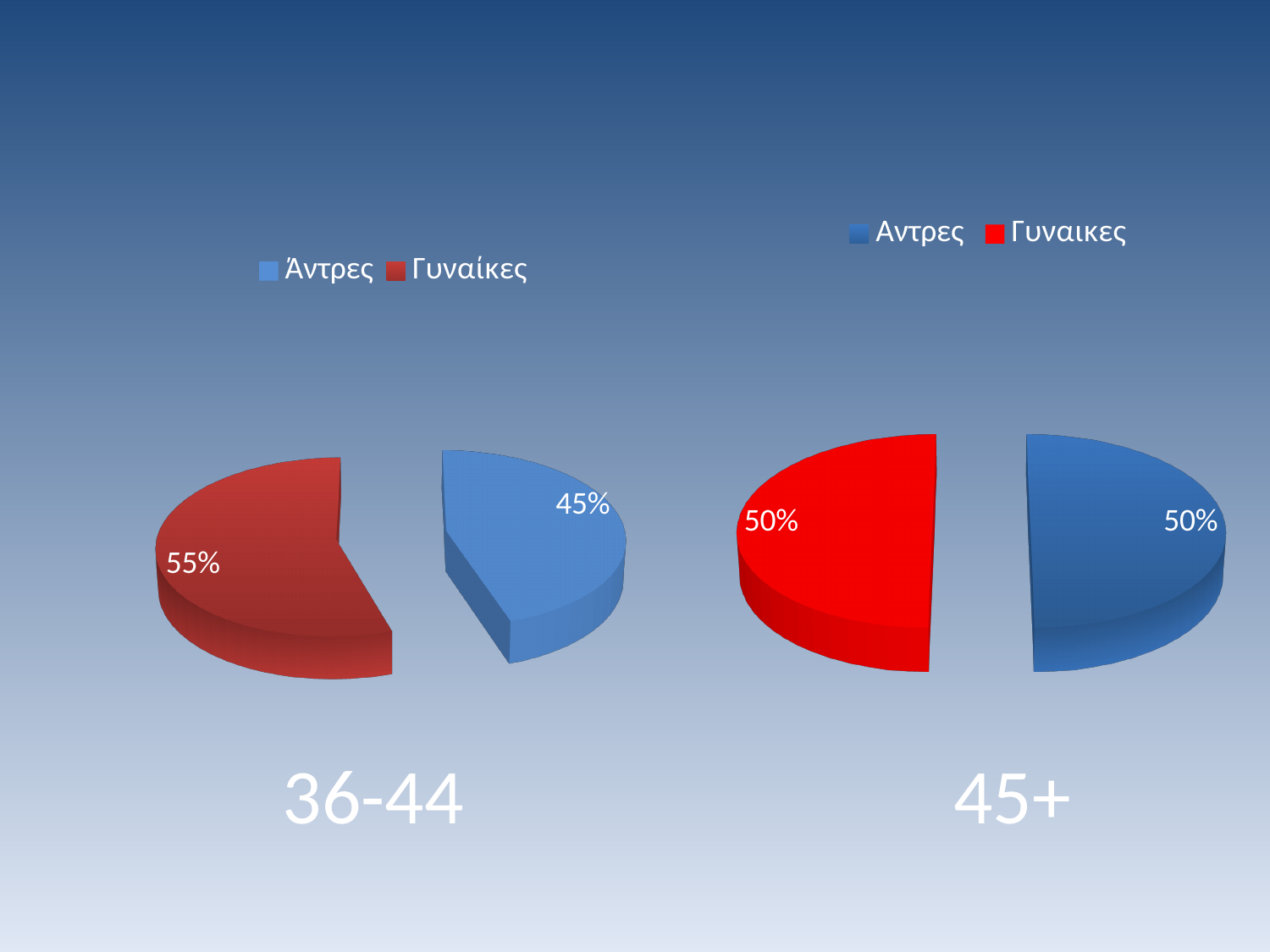
In the 45+ chart, what colour is the Γυναικες slice? red In the 36-44 chart, which category has the larger slice? Γυναίκες What kind of chart is the 45+ chart? pie chart How many entries does the legend of the 45+ chart list? 2 In the 45+ chart, what percentage is shown for Γυναικες? 50% In the 36-44 chart, what percentage is shown for Γυναίκες? 55% In the 36-44 chart, which category has the smaller slice? Άντρες In the 36-44 chart, what is the difference between the Γυναίκες and Άντρες percentages? 10% How many slices does the 36-44 pie chart have? 2 In the 36-44 chart, is the slice for Άντρες larger or smaller than the slice for Γυναίκες? smaller In the 36-44 chart, what percentage is shown for Άντρες? 45% In the 45+ chart, what percentage is shown for Αντρες? 50%